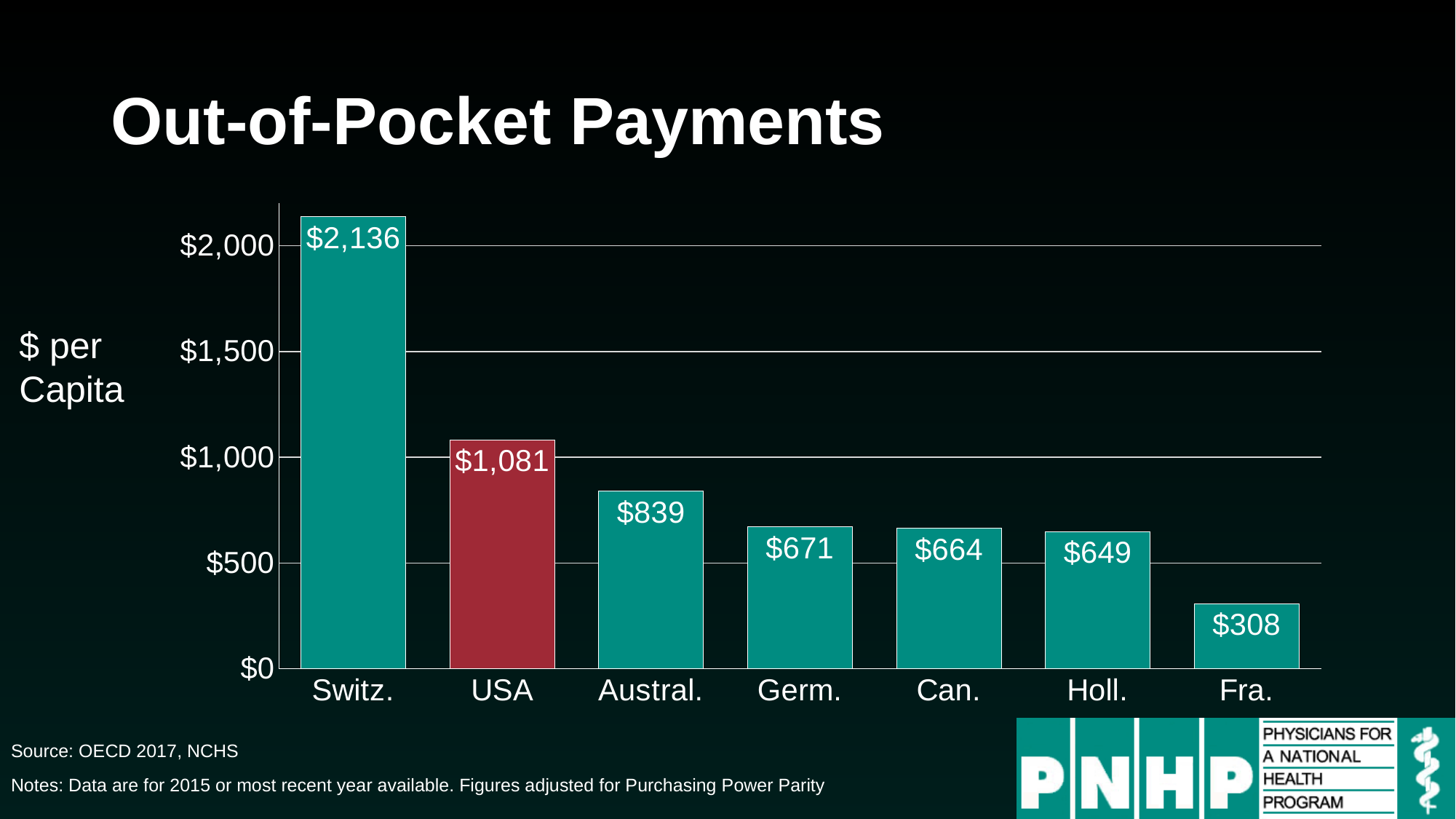
Which country has the lowest out-of-pocket payments per capita? Fra. Is the value for Holl. greater or less than $500? greater How many countries are shown in the chart? 7 Which is larger, the value for the USA or the value for Austral.? USA What is the out-of-pocket payment per capita for the USA? $1,081 What is the difference between the values for Austral. and Germ.? $168 Which country has the highest out-of-pocket payments per capita? Switz. What kind of chart is shown on the slide? Bar chart What is the difference between the values for Switz. and the USA? $1,055 Which bar is coloured differently from the others? USA What is the out-of-pocket payment per capita for Switz.? $2,136 What is the value shown for Fra.? $308